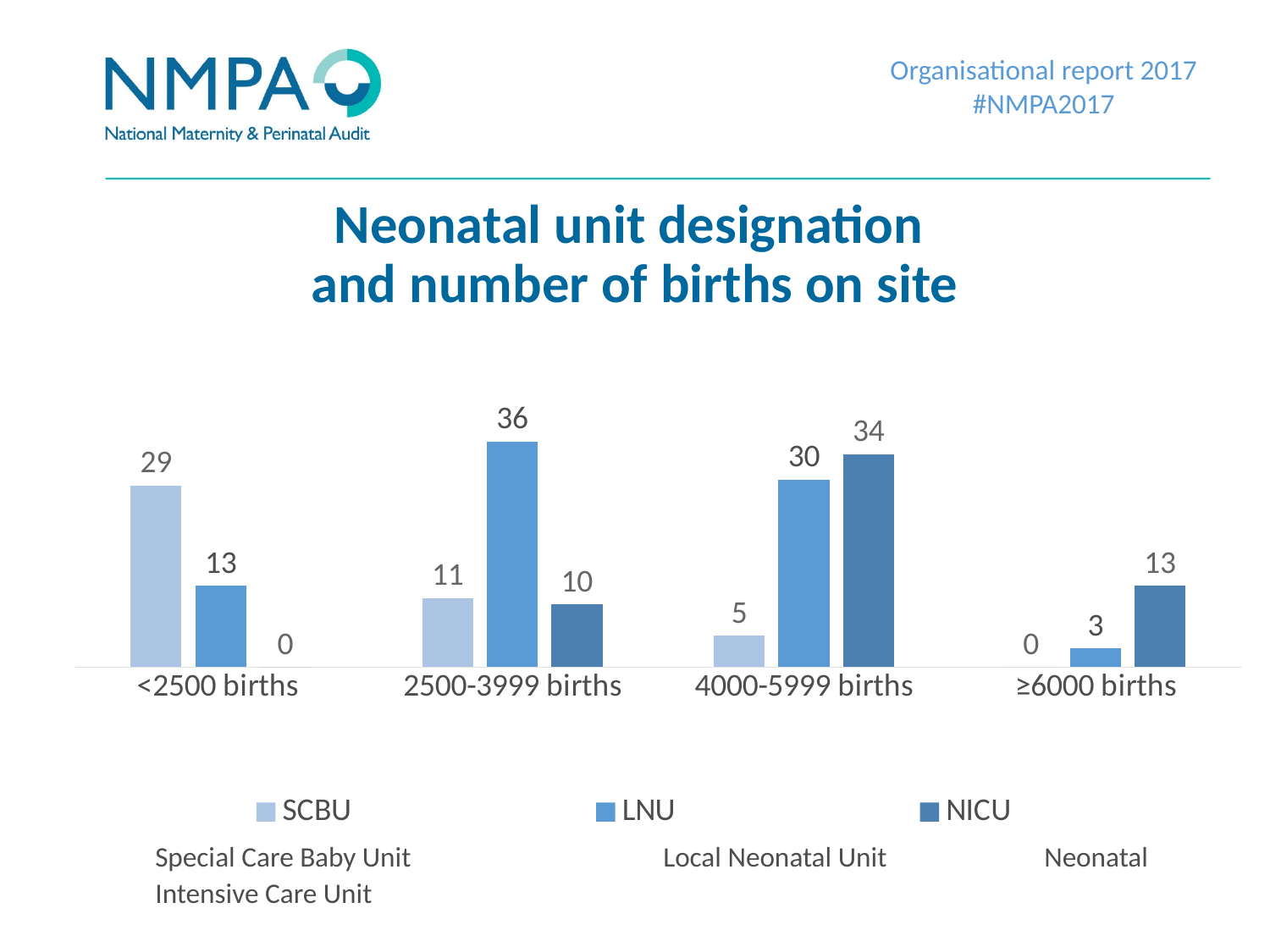
What is the SCBU value for <2500 births? 29 Do the SCBU values rise or fall across the birth categories from left to right? Fall Which is larger for <2500 births, the SCBU value or the LNU value? SCBU What is the difference between the LNU and NICU values for 4000-5999 births? 4 Which birth category has the lowest NICU value? <2500 births What kind of chart is shown on the slide? Bar chart What is the LNU value for 2500-3999 births? 36 What is the NICU value for 4000-5999 births? 34 How many birth categories are shown on the x axis? 4 What is the SCBU value for ≥6000 births? 0 Which birth category has the highest LNU value? 2500-3999 births How many series does the legend list? 3